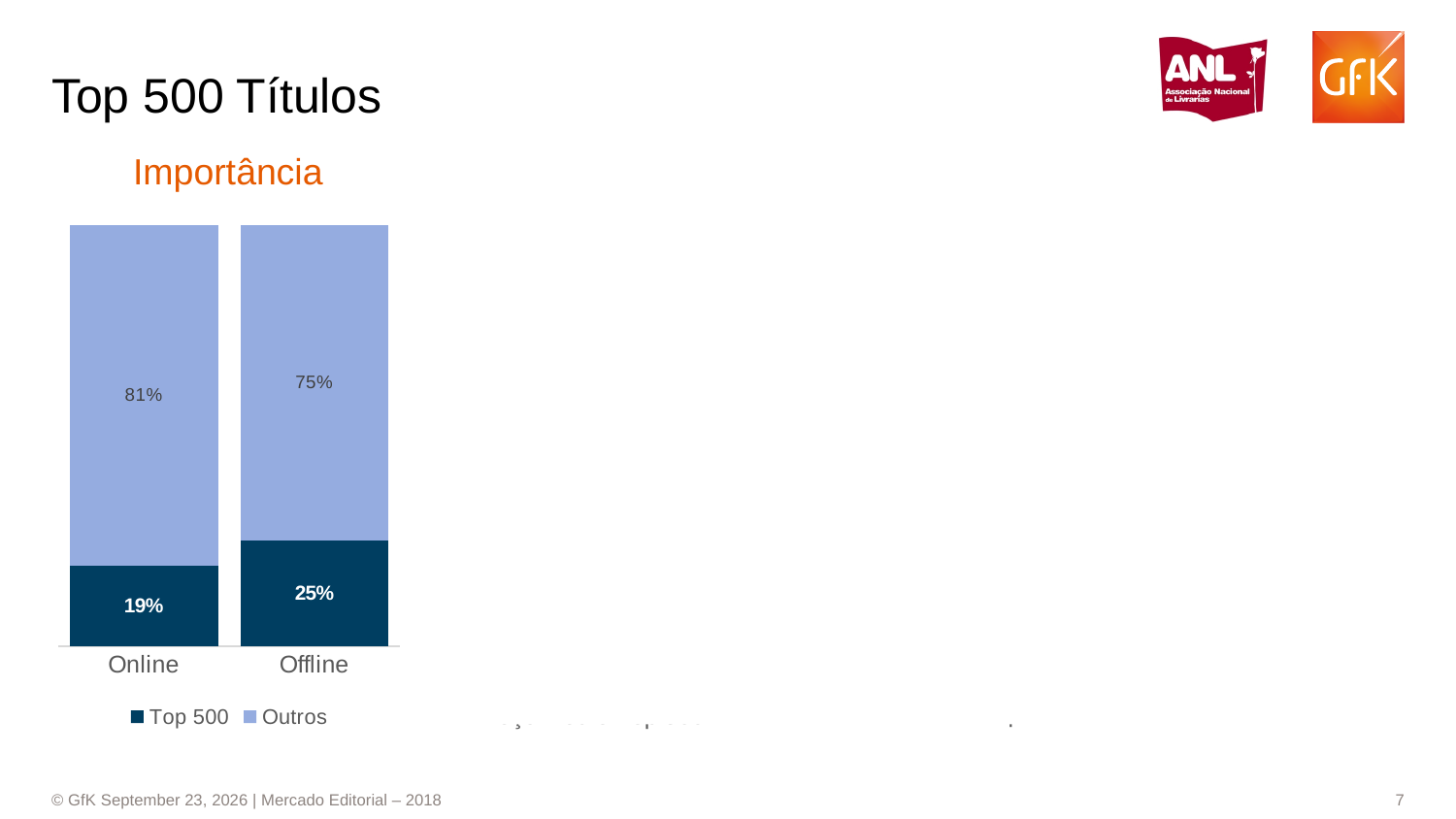
What is the difference between the Top 500 shares for Offline and Online? 6% What is the Outros share for Offline? 75% Which category has the highest Outros share? Online How many categories are shown on the x axis? 2 What is the Outros share for Online? 81% Which category has the higher Top 500 share, Online or Offline? Offline What is the difference between the Outros shares for Online and Offline? 6% What is the Top 500 share for Offline? 25% How many series does the legend list? 2 What is the total of the stacked bar for Online? 100% What kind of chart is shown on the slide? Stacked bar chart What is the Top 500 share for Online? 19%